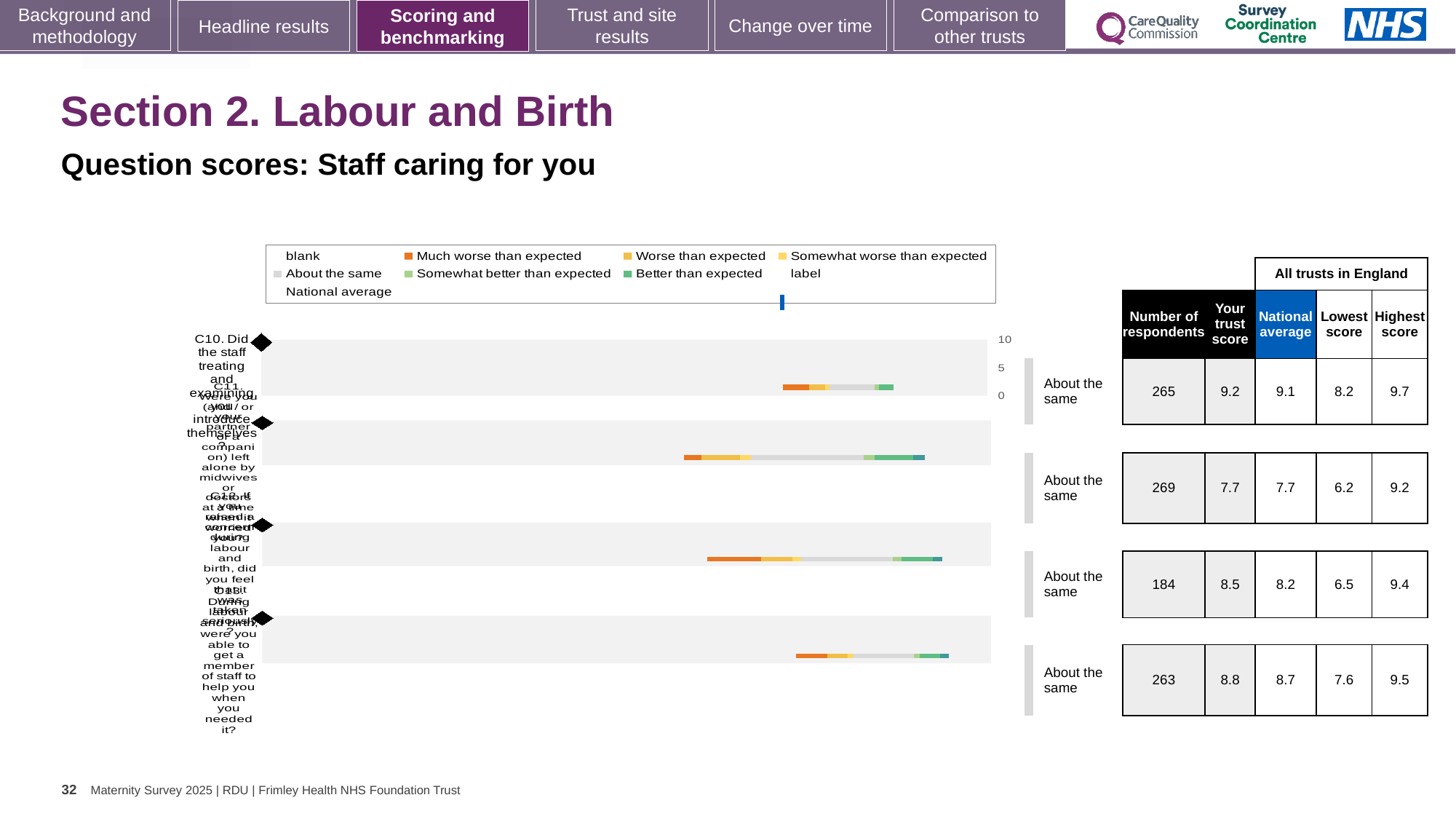
What is the National average for the fourth question row (C15)? 8.7 Which legend entry is shown with an orange colour? Much worse than expected What kind of chart is shown on the slide? bar chart For the third question row (C14), which is larger: Your trust score or the National average? Your trust score How many question rows (bars) are plotted in the chart? 4 What is Your trust score for the second question row (C11)? 7.7 What is the difference in Number of respondents between the first row (265) and the third row (184)? 81 What benchmark category is shown for all four question rows? About the same Which question row has the lowest Number of respondents? C14 (184) Which question row has the highest Your trust score? C10 (9.2) For the first question row (C10), what is the difference between the Highest score and the Lowest score? 1.5 What is the Number of respondents for the first question row (C10)? 265